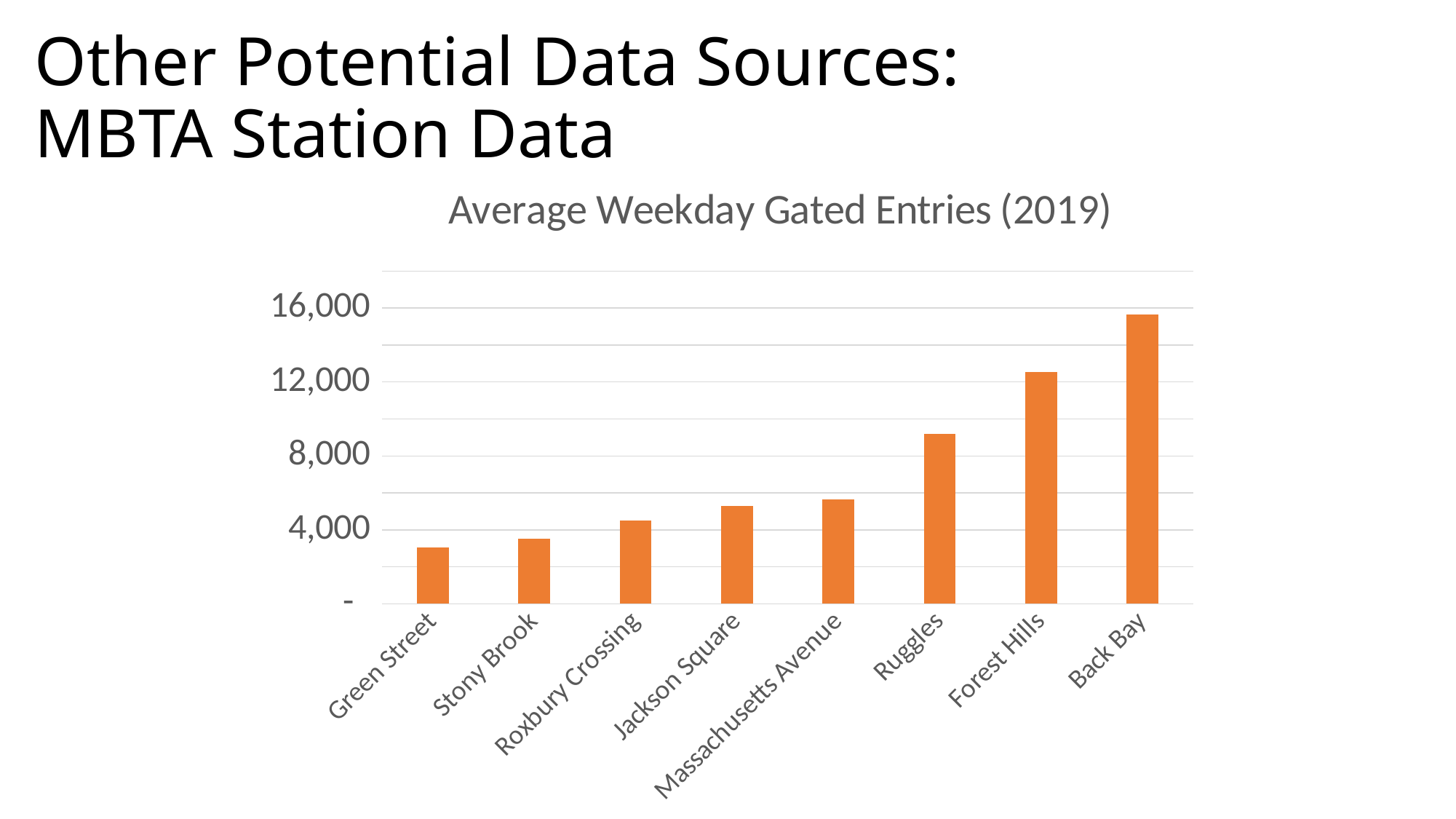
Is the value for Ruggles greater or less than 8,000? greater Do the bar values rise or fall from left to right across the stations? rise Which has more average weekday gated entries, Forest Hills or Ruggles? Forest Hills Is the value for Back Bay greater or less than 12,000? greater Which station has the lowest average weekday gated entries? Green Street What is the title of the chart? Average Weekday Gated Entries (2019) Is the value for Roxbury Crossing greater or less than 8,000? less Which station has the highest average weekday gated entries? Back Bay What kind of chart is shown on the slide? bar chart How many stations are shown on the chart? 8 Which has more average weekday gated entries, Stony Brook or Jackson Square? Jackson Square